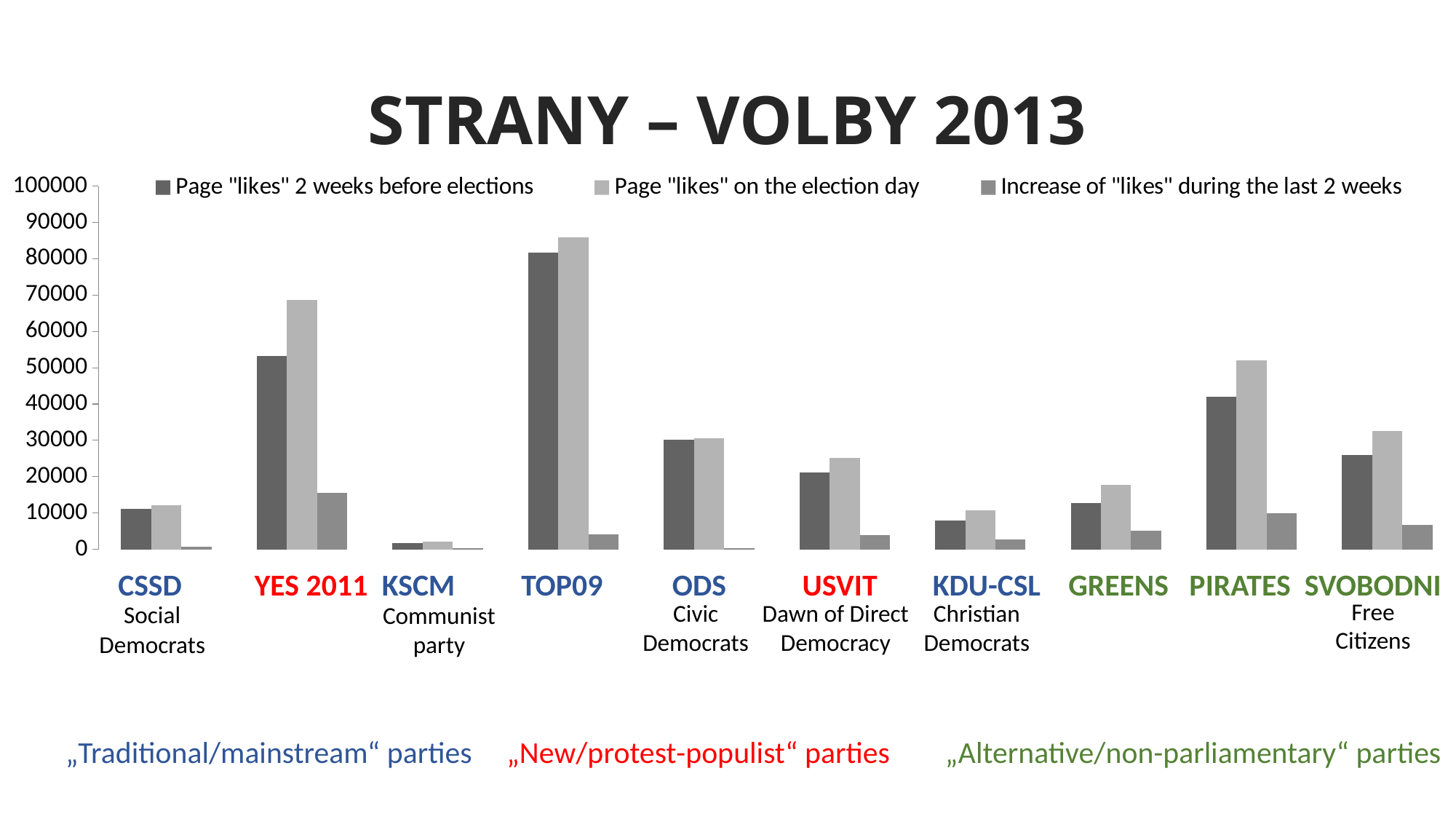
Is the value of page "likes" 2 weeks before elections for SVOBODNI greater or less than 30000? less Which party has the lowest number of page "likes" on the election day? KSCM How many series does the legend list? 3 Is the value of page "likes" on the election day for YES 2011 greater or less than 60000? greater How many parties (categories) are shown on the x axis? 10 What is the title of the chart on the slide? STRANY – VOLBY 2013 Which has a larger increase of "likes" during the last 2 weeks, YES 2011 or PIRATES? YES 2011 Which party has the largest increase of "likes" during the last 2 weeks? YES 2011 Is the value of page "likes" 2 weeks before elections for TOP09 greater or less than 70000? greater Which has more page "likes" on the election day, PIRATES or SVOBODNI? PIRATES What kind of chart is shown on the slide? bar chart Which party has the highest number of page "likes" on the election day? TOP09